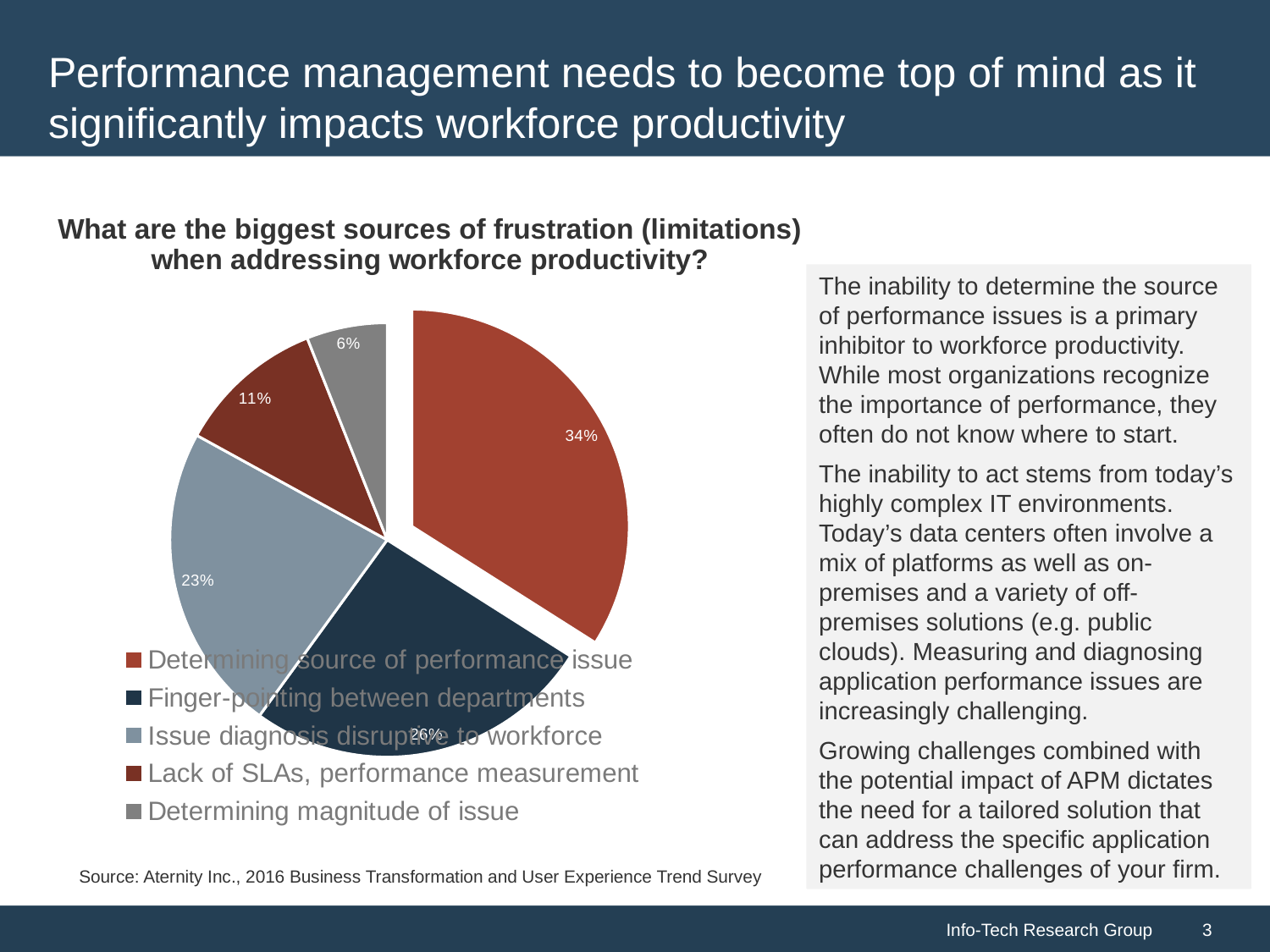
What percentage is shown for "Issue diagnosis disruptive to workforce"? 23% Which is larger: the slice for "Issue diagnosis disruptive to workforce" or the slice for "Lack of SLAs, performance measurement"? Issue diagnosis disruptive to workforce What percentage is shown for "Lack of SLAs, performance measurement"? 11% How many categories does the pie chart show? 5 Which category has the largest slice of the pie? Determining source of performance issue What percentage is shown for "Determining magnitude of issue"? 6% What share of the pie is labelled for "Determining source of performance issue"? 34% Which category has the smallest slice of the pie? Determining magnitude of issue What type of chart is shown on the slide? Pie chart What percentage is shown for "Finger-pointing between departments"? 26% What is the difference in percentage points between "Determining source of performance issue" and "Finger-pointing between departments"? 8 What is the title of the chart? What are the biggest sources of frustration (limitations) when addressing workforce productivity?